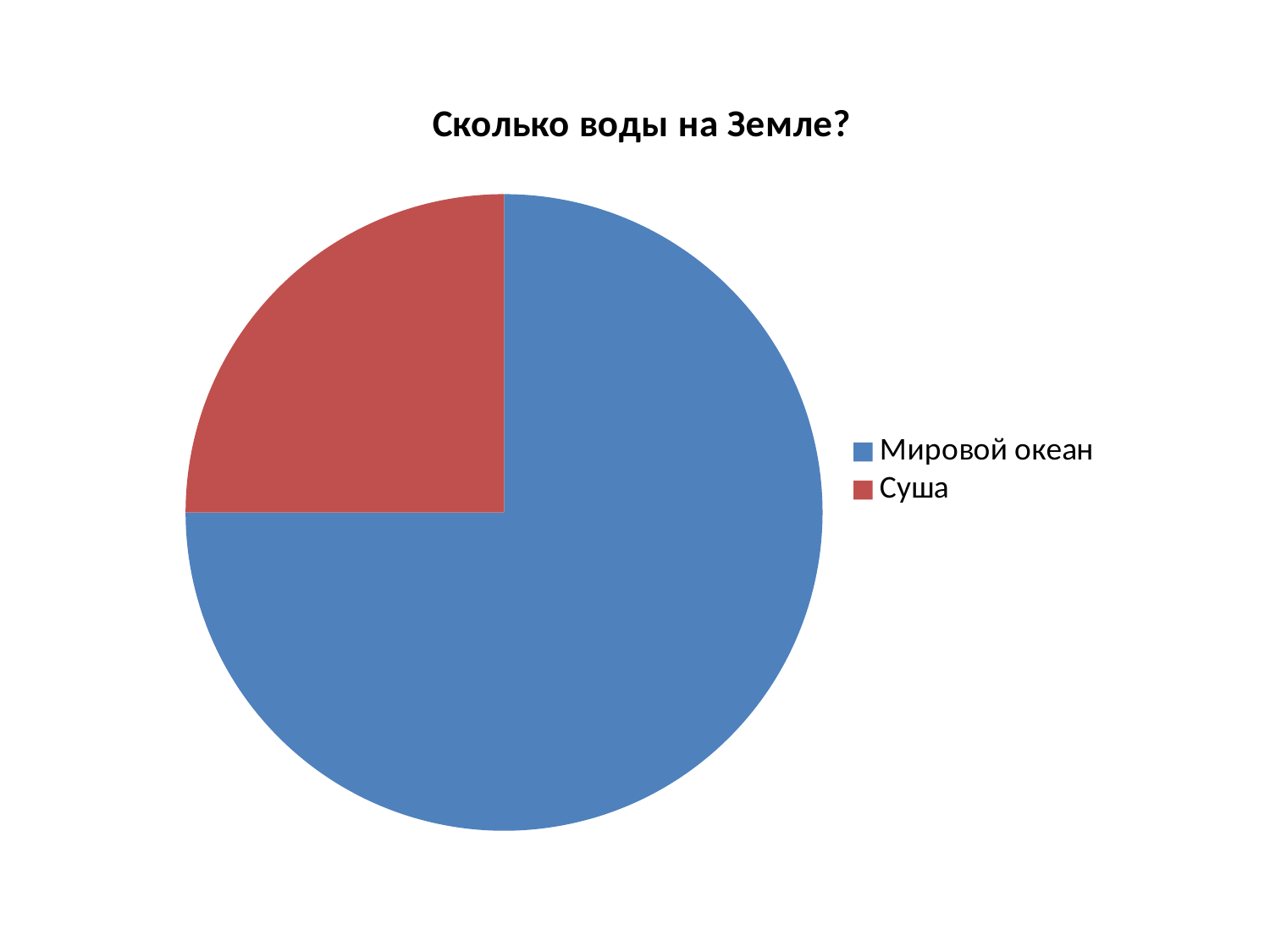
How many slices does the pie chart have? 2 How many entries does the legend list? 2 What is the title of the chart? Сколько воды на Земле? Which category has the smallest slice of the pie? Суша Which category has the largest slice of the pie? Мировой океан What colour is the slice for Суша? Red What kind of chart is shown on the slide? Pie chart Which slice is larger, Мировой океан or Суша? Мировой океан